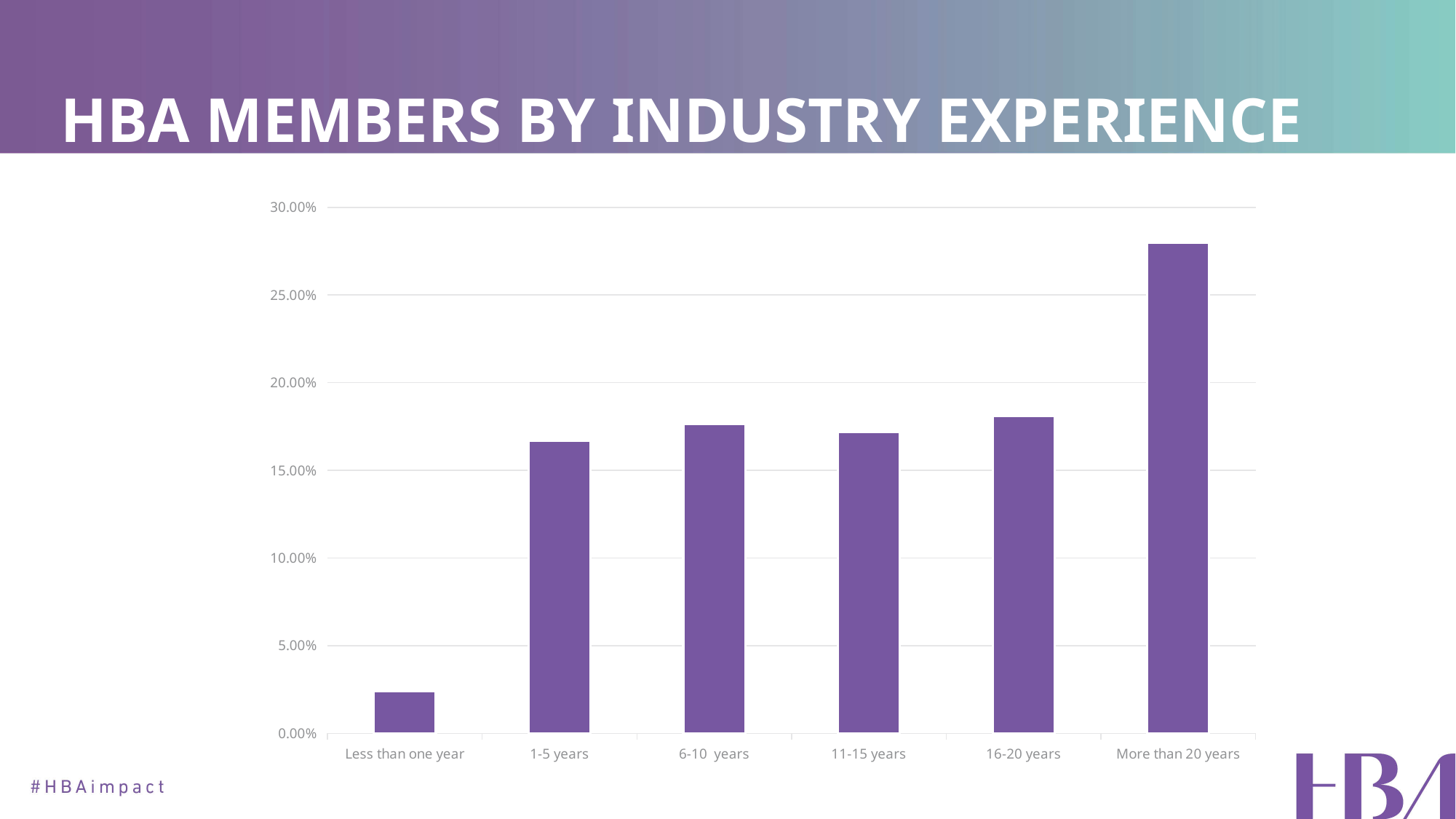
Does the value rise or fall from 16-20 years to More than 20 years? rise How many experience categories are shown on the x axis? 6 What kind of chart is shown on the slide? bar chart Is the value for 11-15 years greater or less than 20.00%? less Which experience category has the lowest share of HBA members? Less than one year Is the value for 16-20 years greater or less than 15.00%? greater Is the value for Less than one year greater or less than 5.00%? less What is the title of the slide containing the chart? HBA MEMBERS BY INDUSTRY EXPERIENCE Which is larger, the value for 16-20 years or the value for More than 20 years? More than 20 years Which experience category has the highest share of HBA members? More than 20 years Which is larger, the value for Less than one year or the value for 1-5 years? 1-5 years